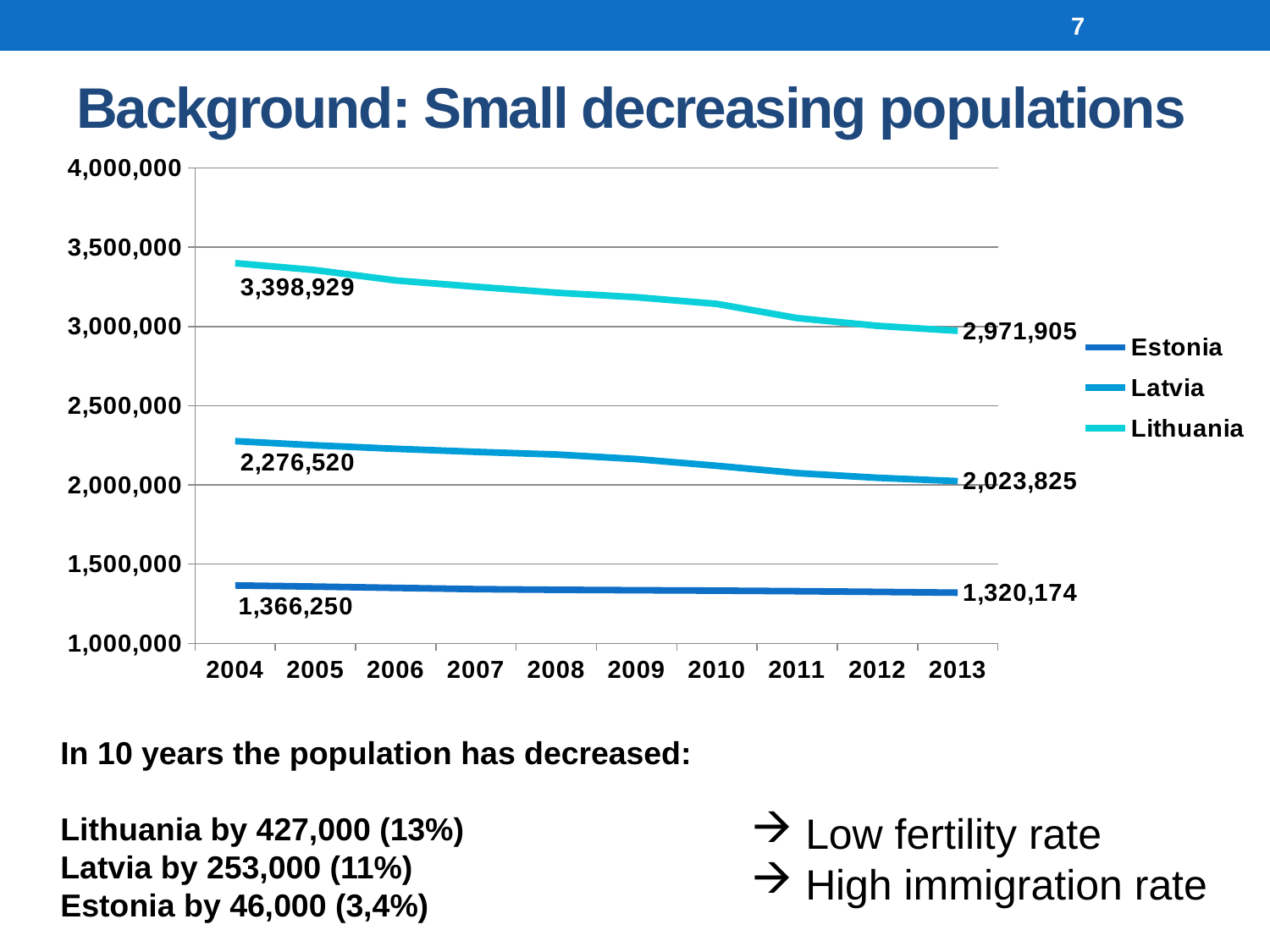
What was Lithuania's population in 2013 according to the chart? 2,971,905 Is the value for Lithuania in 2008 greater or less than 3,000,000? greater What was Estonia's population in 2013 according to the chart? 1,320,174 Which was larger in 2004: Latvia's population or Estonia's population? Latvia What kind of chart is shown on the slide? Line chart By how much did Latvia's population decrease from 2004 (2,276,520) to 2013 (2,023,825)? 252,695 Which country had the lowest population in 2004? Estonia How many years are shown on the x axis of the chart? 10 What was Lithuania's population in 2004 according to the chart? 3,398,929 What was Latvia's population in 2004 according to the chart? 2,276,520 How many series does the chart's legend list? 3 Which country had the highest population in 2013? Lithuania